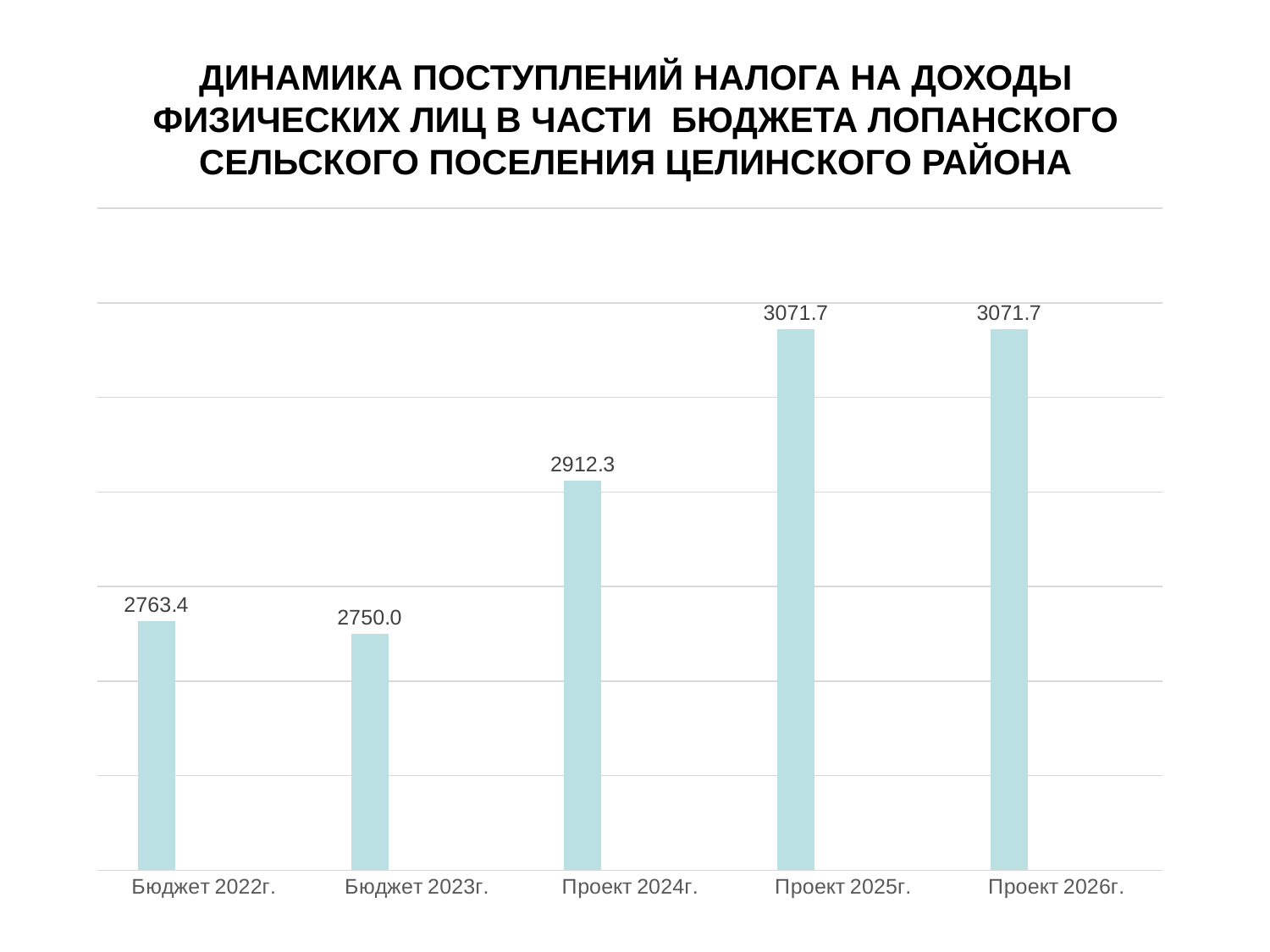
What is the difference between the values for Проект 2025г. and Проект 2024г.? 159.4 How many categories are shown on the x axis? 5 What kind of chart is shown on the slide? Bar chart What is the difference between the values for Проект 2024г. and Бюджет 2023г.? 162.3 What is the value for Проект 2026г.? 3071.7 Do the values rise or fall from Бюджет 2023г. to Проект 2025г.? Rise What is the value for Проект 2025г.? 3071.7 What is the value for Бюджет 2023г.? 2750.0 Which is larger, the value for Бюджет 2022г. or Бюджет 2023г.? Бюджет 2022г. Which category has the lowest value? Бюджет 2023г. What is the value for Бюджет 2022г.? 2763.4 What is the value for Проект 2024г.? 2912.3